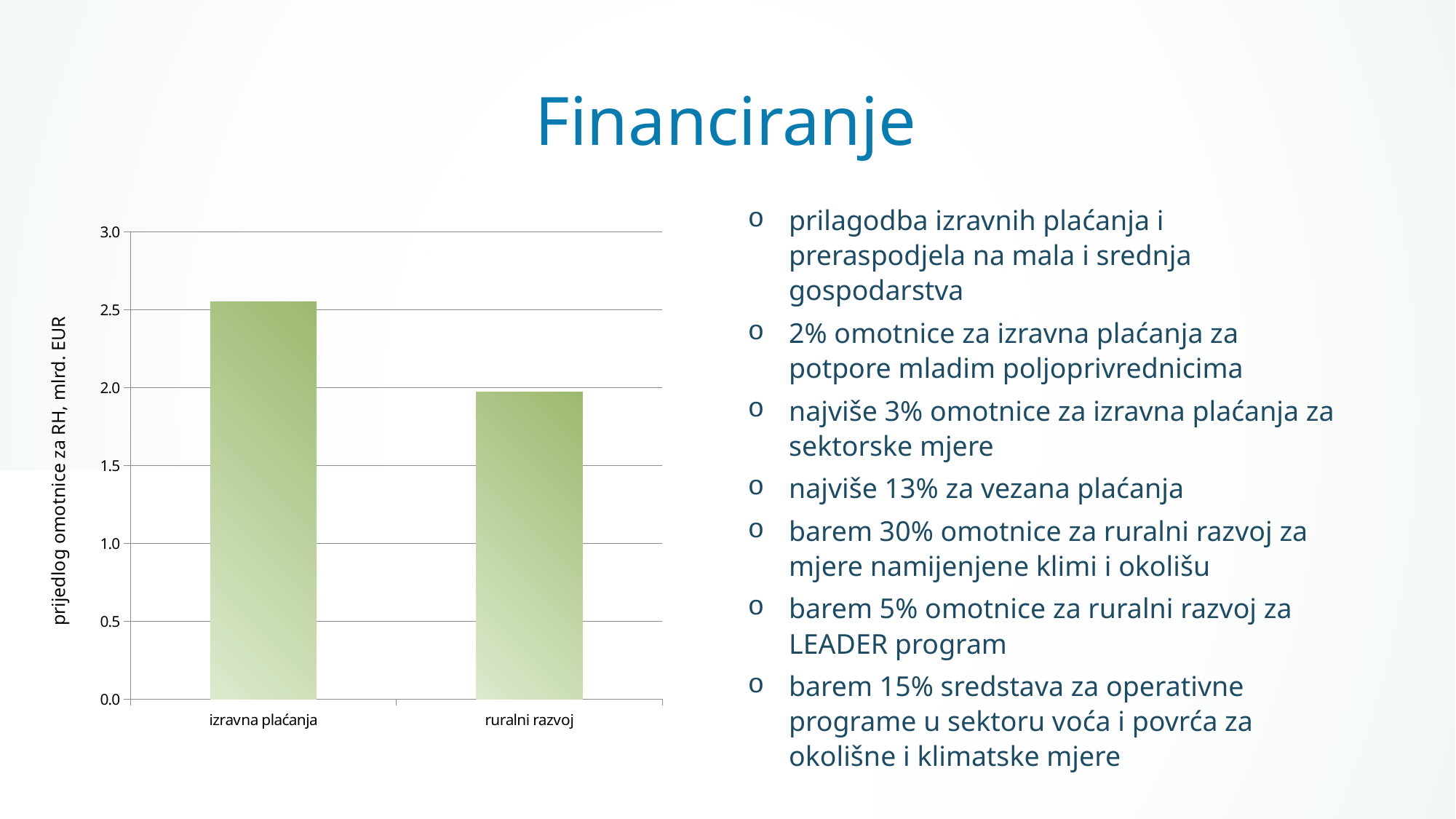
Is the value for izravna plaćanja greater or less than 3.0? less Is the value for ruralni razvoj greater or less than 2.5? less Is the value for ruralni razvoj greater or less than 1.5? greater What kind of chart is shown on the slide? bar chart Which is larger, the value for izravna plaćanja or the value for ruralni razvoj? izravna plaćanja How many categories are plotted in the chart? 2 What is the highest value shown on the vertical axis of the chart? 3.0 Do the bar values rise or fall from left to right along the x axis? fall Which category has the highest value in the chart? izravna plaćanja What is the label of the vertical axis of the chart? prijedlog omotnice za RH, mlrd. EUR Which category has the lowest value in the chart? ruralni razvoj